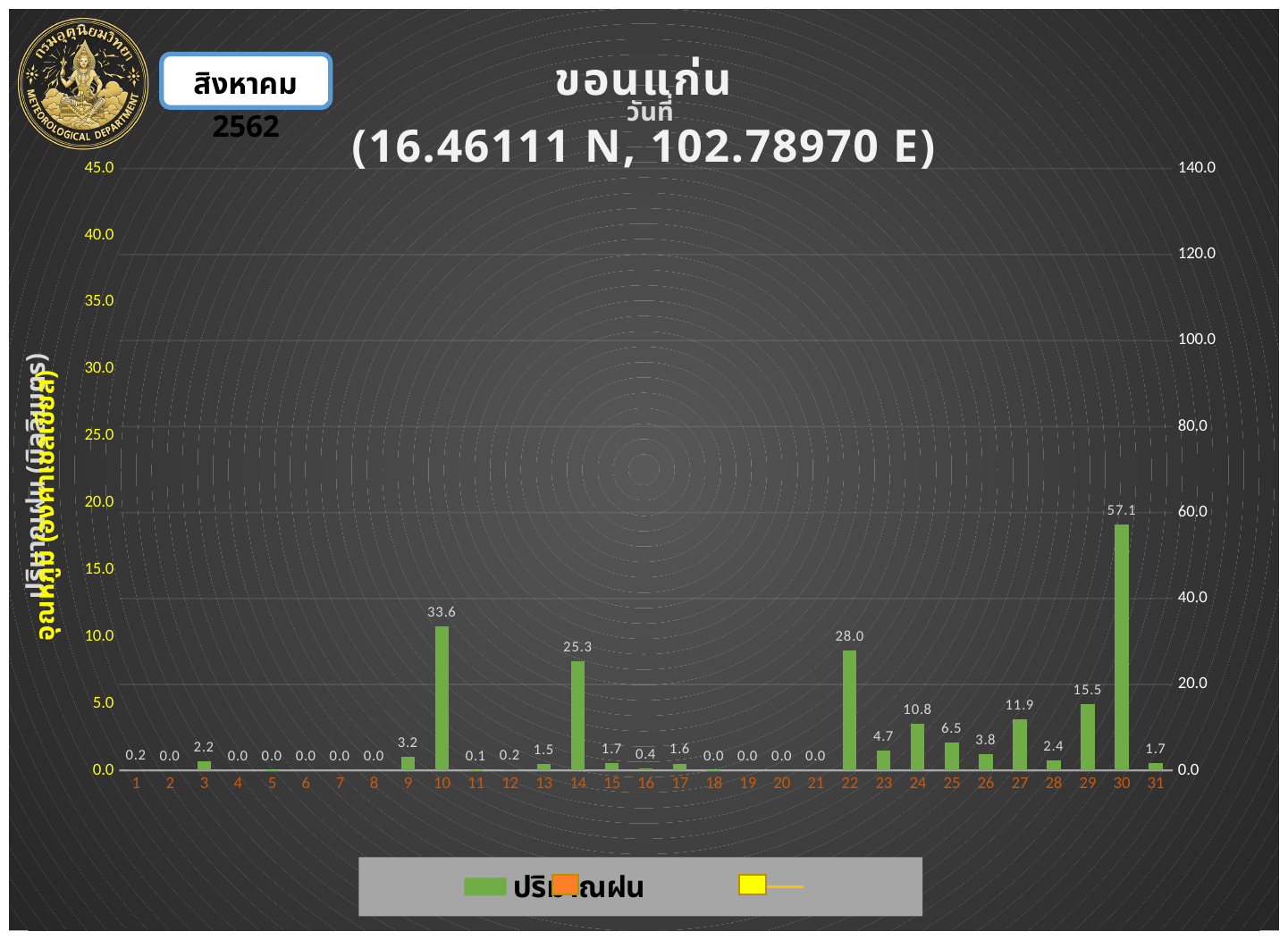
What is the difference between the rainfall values for day 30 and day 10? 23.5 How many days are shown on the x axis of the chart? 31 What are the coordinates given in the chart title? 16.46111 N, 102.78970 E What is the difference between the rainfall values for day 14 and day 22? 2.7 What is the rainfall value shown for day 22? 28.0 What is the rainfall value shown for day 30? 57.1 What is the rainfall value shown for day 24? 10.8 What kind of chart is shown on the slide? bar chart Which day has the highest rainfall value? 30 Which is larger, the rainfall value for day 29 or for day 27? day 29 What is the rainfall value shown for day 10? 33.6 Which is larger, the rainfall value for day 14 or for day 24? day 14